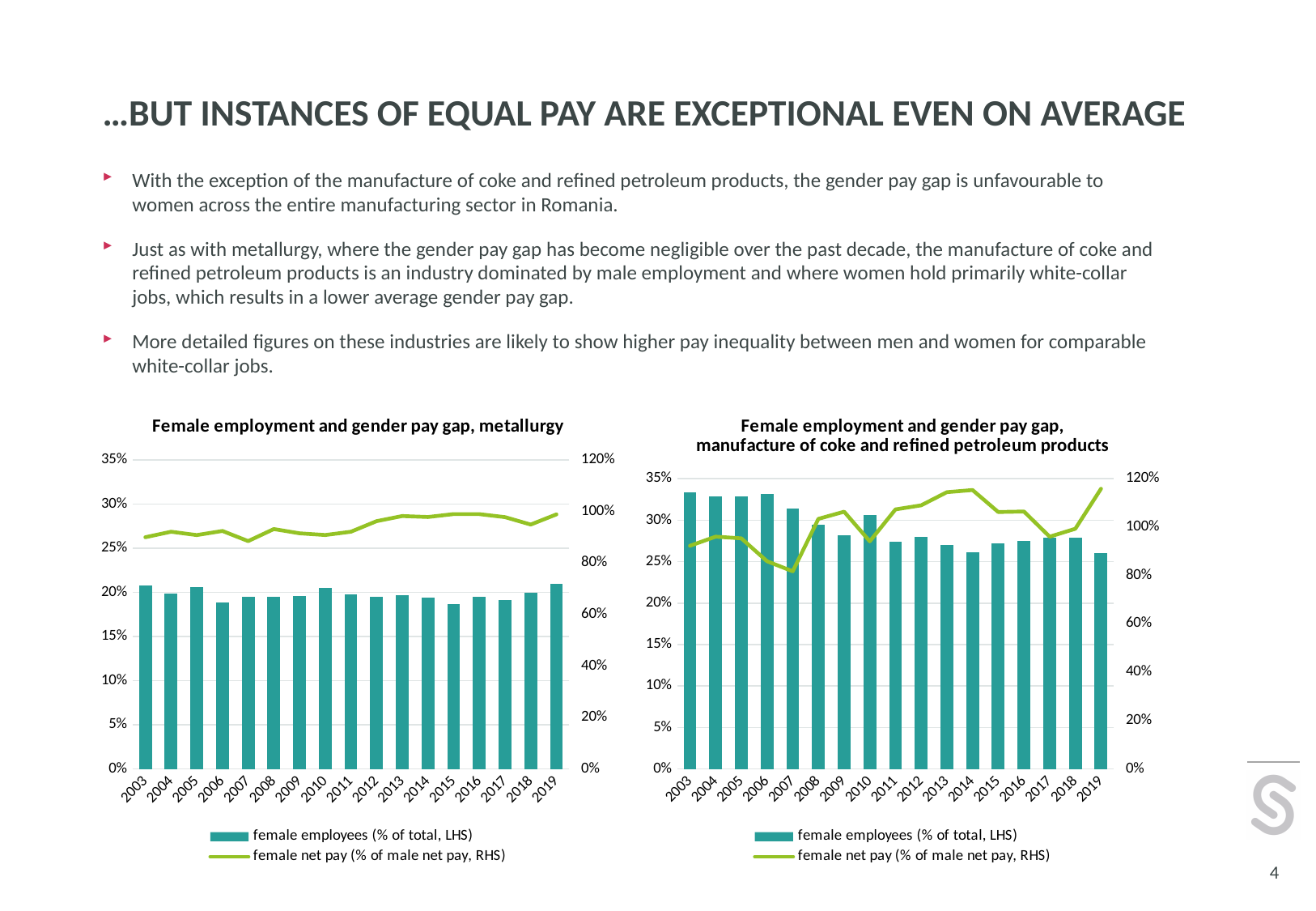
In the metallurgy chart, is the value for female employees (% of total) in 2015 greater or less than 20%? less In the metallurgy chart, which is larger: female employees (% of total) in 2019 or in 2015? 2019 What kind of chart is the 'Female employment and gender pay gap, metallurgy' chart? A combined bar and line chart In the 'manufacture of coke and refined petroleum products' chart, which year has the lowest female net pay (% of male net pay)? 2007 In the 'manufacture of coke and refined petroleum products' chart, which is larger: female employees (% of total) in 2003 or in 2019? 2003 In the 'manufacture of coke and refined petroleum products' chart, is female net pay (% of male net pay) in 2007 greater or less than 100%? less In the 'manufacture of coke and refined petroleum products' chart, do the female employees (% of total) bars generally rise or fall from 2003 to 2019? fall In the 'manufacture of coke and refined petroleum products' chart, is the value for female employees (% of total) in 2003 greater or less than 30%? greater In the metallurgy chart, how many series does the legend list? 2 In the metallurgy chart, how many years are shown on the x axis? 17